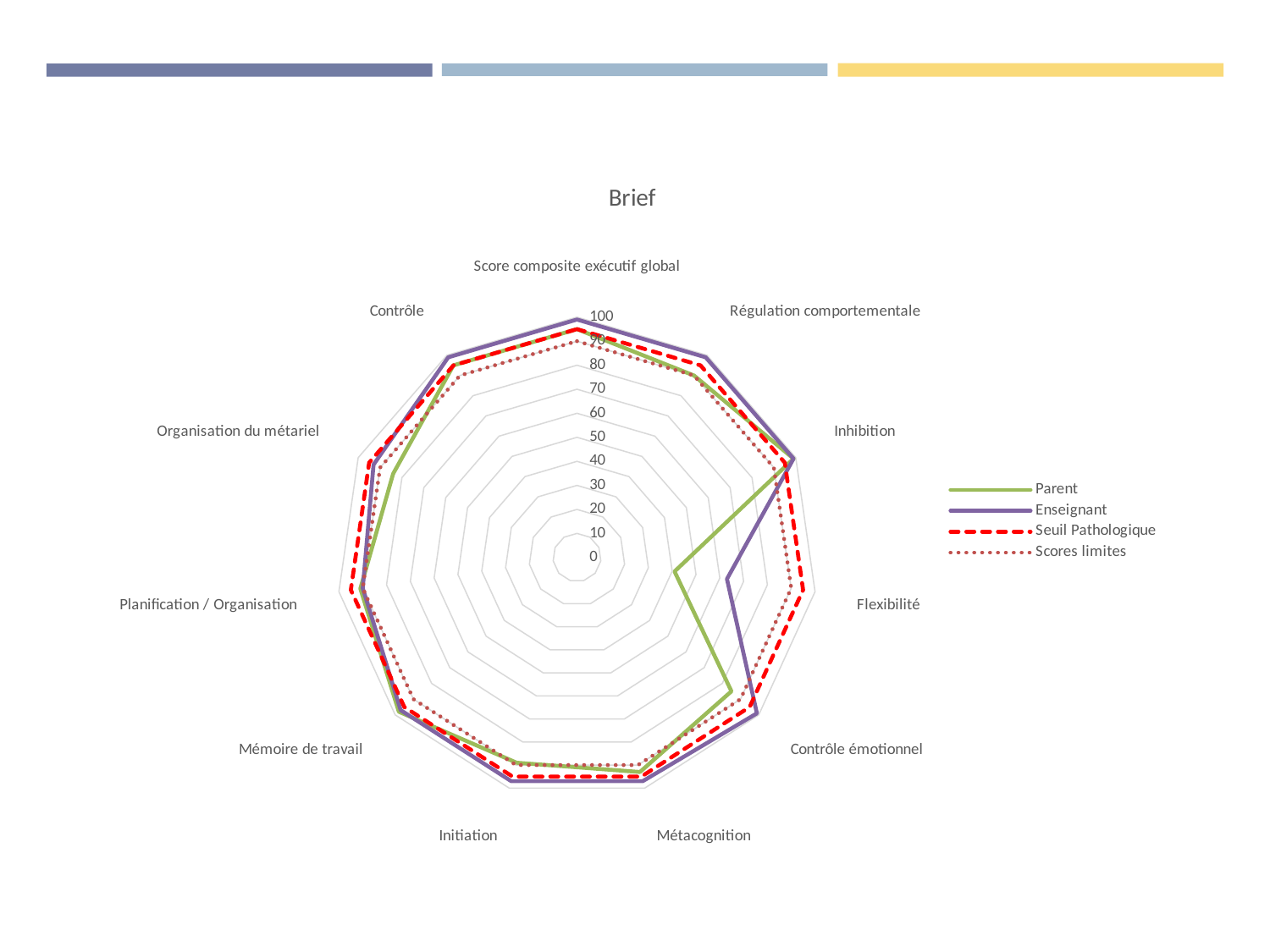
For which category is the Parent series lowest? Flexibilité Is the Parent value for Flexibilité greater or less than 50? less For which category is the Enseignant series lowest? Flexibilité What kind of chart is shown on the slide? Radar chart For Flexibilité, which is larger: the Parent value or the Enseignant value? Enseignant Which series is drawn with a red dashed line? Seuil Pathologique Is the Enseignant value for Score composite exécutif global greater or less than 90? greater What is the title of the chart? Brief How many categories (axes) does the radar chart have? 11 Is the Parent value for Organisation du métariel greater or less than 90? less How many series does the legend list? 4 For Contrôle émotionnel, which is larger: the Parent value or the Enseignant value? Enseignant